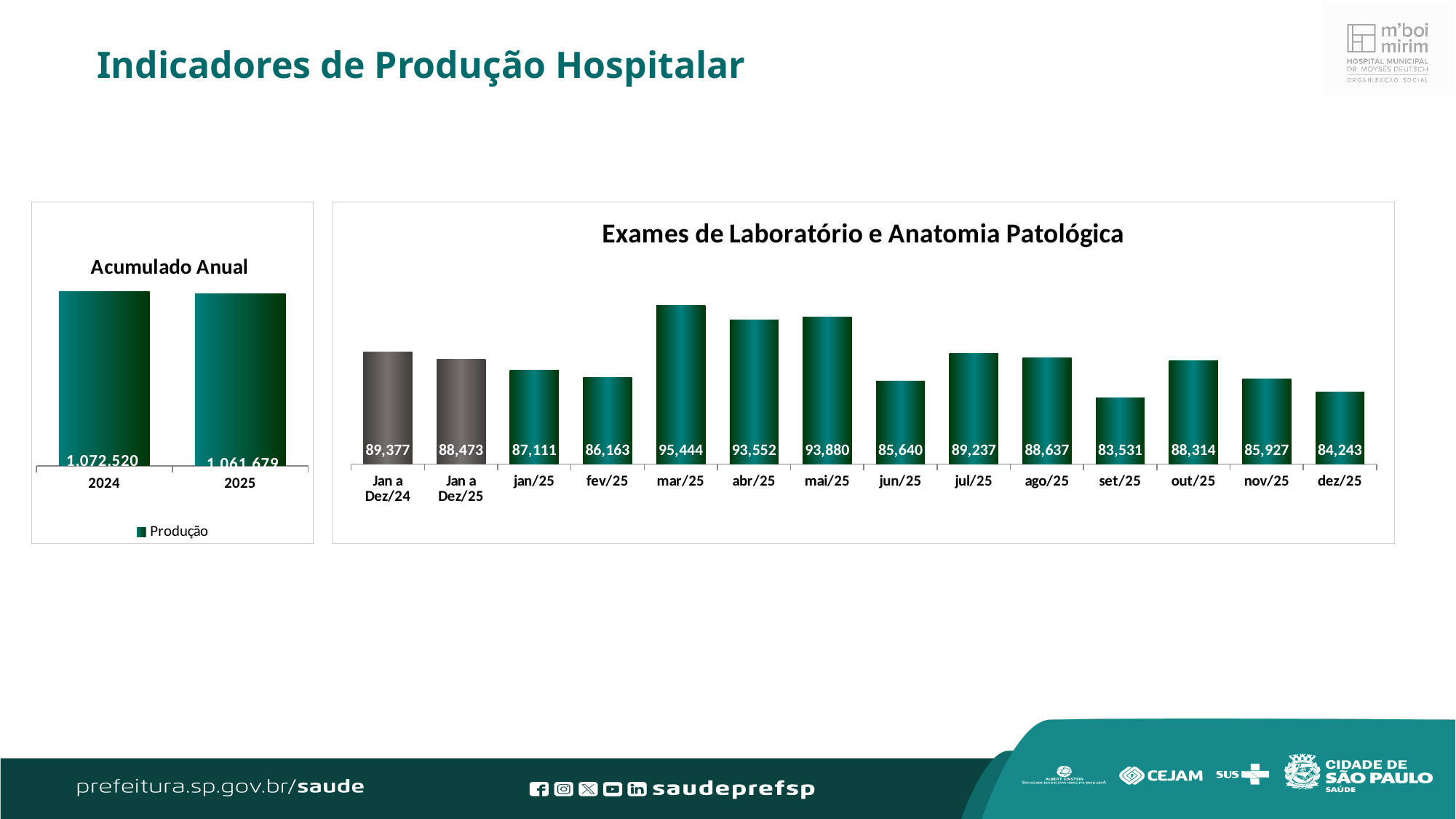
In the Exames de Laboratório e Anatomia Patológica chart, what is the difference between the mar/25 and set/25 values? 11,913 In the Acumulado Anual chart, what is the value for 2025? 1,061,679 In the Exames de Laboratório e Anatomia Patológica chart, which category has the highest value? mar/25 In the Acumulado Anual chart, which year has the higher value, 2024 or 2025? 2024 What type of chart is the Acumulado Anual chart? Bar chart In the Exames de Laboratório e Anatomia Patológica chart, what is the value for mar/25? 95,444 How many bars are shown in the Exames de Laboratório e Anatomia Patológica chart? 14 In the Exames de Laboratório e Anatomia Patológica chart, which is larger, jul/25 or ago/25? jul/25 In the Exames de Laboratório e Anatomia Patológica chart, what is the value for Jan a Dez/25? 88,473 In the Acumulado Anual chart, what is the difference between the 2024 and 2025 values? 10,841 In the Exames de Laboratório e Anatomia Patológica chart, which category has the lowest value? set/25 In the Acumulado Anual chart, what is the value for 2024? 1,072,520